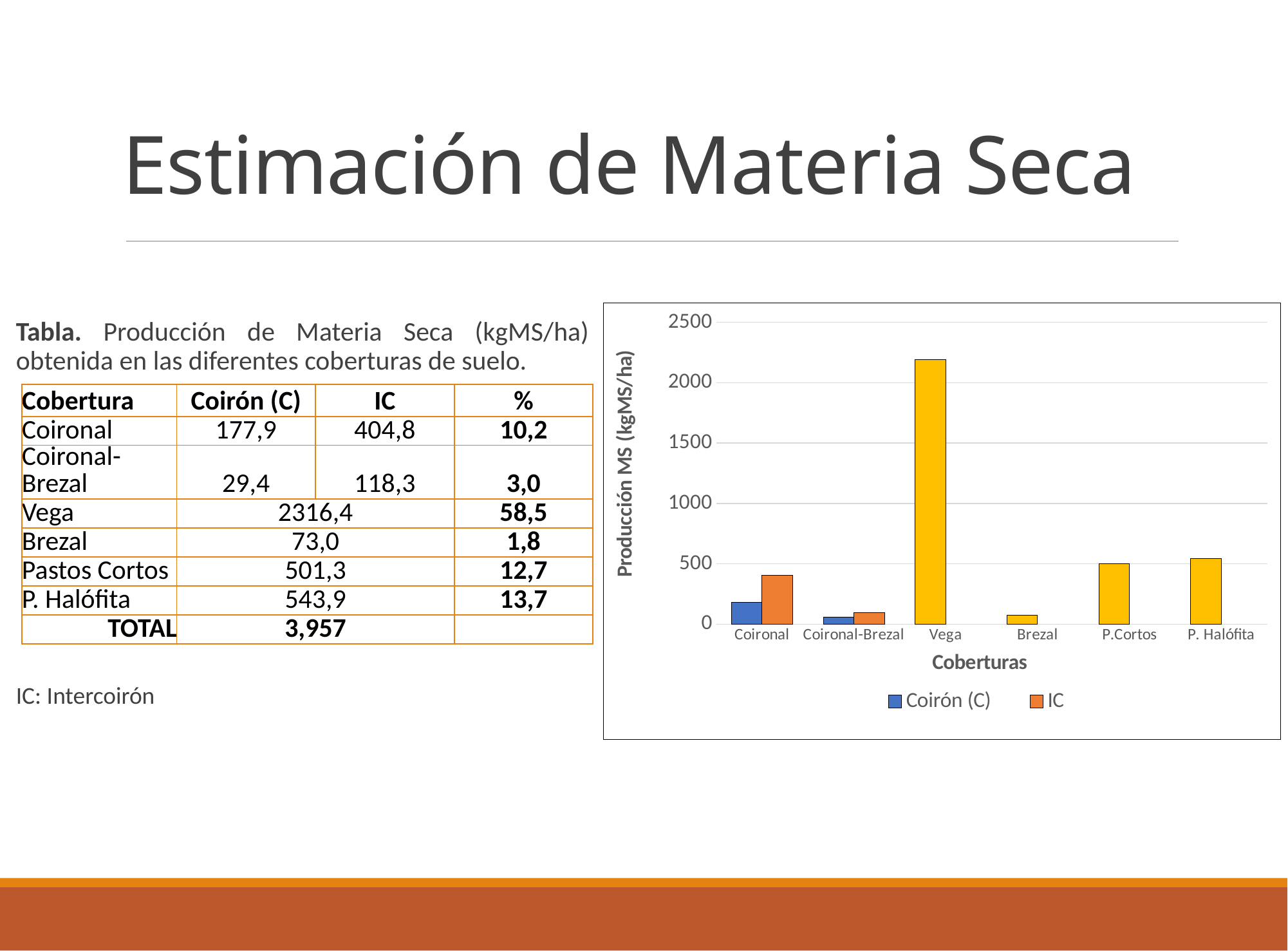
Is the IC value for Coironal greater or less than 500? less Which is larger: the bar for Vega or the bar for P. Halófita? Vega Is the value for P. Halófita greater or less than 500? greater Which category has the highest bar in the chart? Vega How many categories are shown on the x axis of the chart? 6 Is the value for Vega greater or less than 2000? greater What kind of chart is shown on the slide? bar chart How many series does the chart legend list? 2 For Coironal, which is larger: the Coirón (C) bar or the IC bar? IC What is the title of the x axis of the chart? Coberturas What is the title of the y axis of the chart? Producción MS (kgMS/ha)